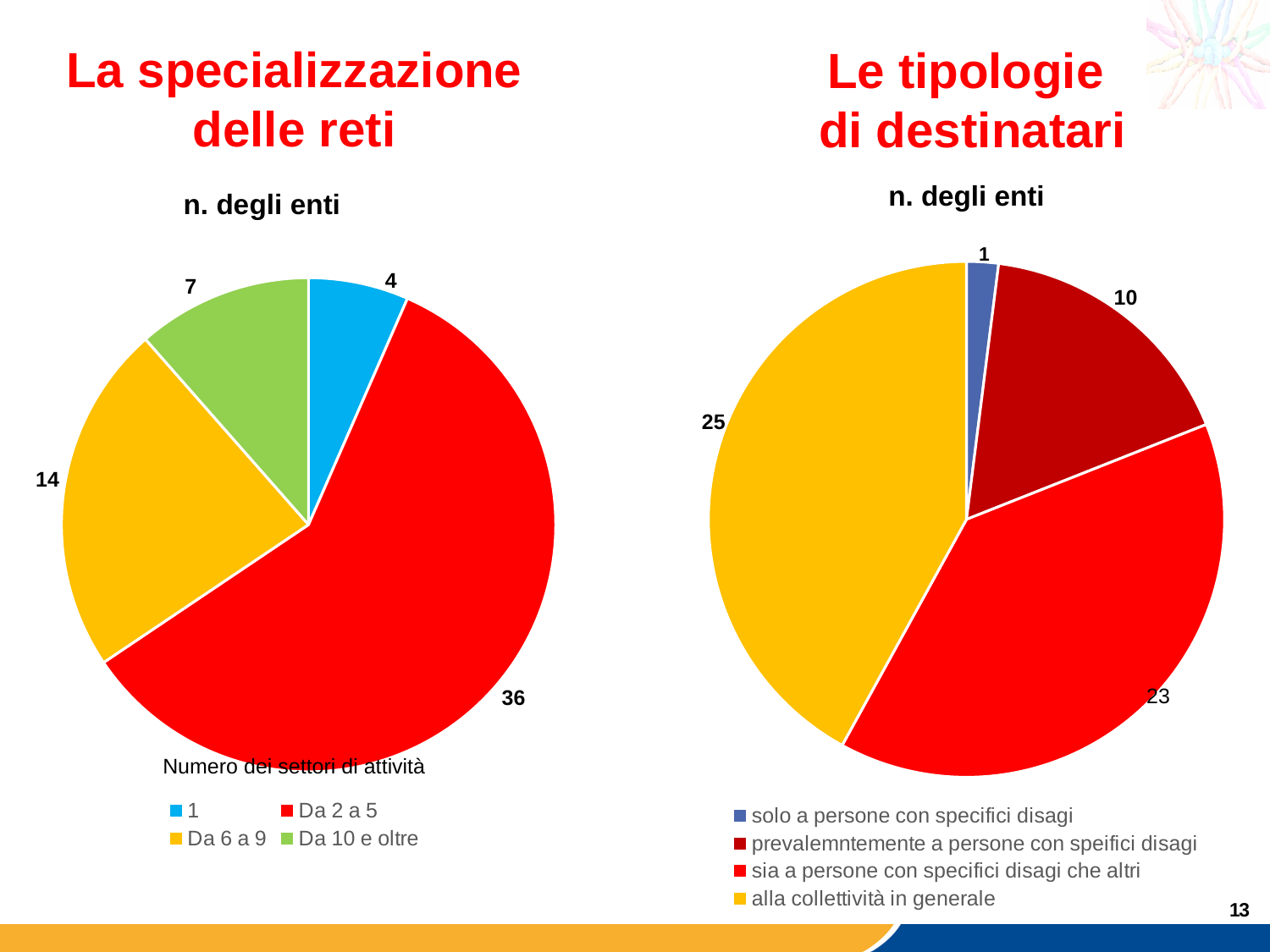
In the chart titled 'La specializzazione delle reti', what is the value for 'Da 2 a 5'? 36 What kind of chart is used in 'Le tipologie di destinatari'? pie chart In the chart titled 'La specializzazione delle reti', which category has the smallest slice? 1 In the chart titled 'La specializzazione delle reti', what is the difference between the values for 'Da 6 a 9' and 'Da 10 e oltre'? 7 In the chart titled 'Le tipologie di destinatari', what is the value for 'alla collettività in generale'? 25 In the chart titled 'La specializzazione delle reti', how many slices does the pie have? 4 In the chart titled 'Le tipologie di destinatari', what is the difference between the values for 'alla collettività in generale' and 'sia a persone con specifici disagi che altri'? 2 In the chart titled 'Le tipologie di destinatari', which category has the largest slice? alla collettività in generale In the chart titled 'Le tipologie di destinatari', what is the value for 'solo a persone con specifici disagi'? 1 In the chart titled 'Le tipologie di destinatari', which is larger: 'prevalemntemente a persone con speifici disagi' or 'sia a persone con specifici disagi che altri'? sia a persone con specifici disagi che altri In the chart titled 'La specializzazione delle reti', what is the total of all slices? 61 In the chart titled 'La specializzazione delle reti', what is the value for 'Da 10 e oltre'? 7